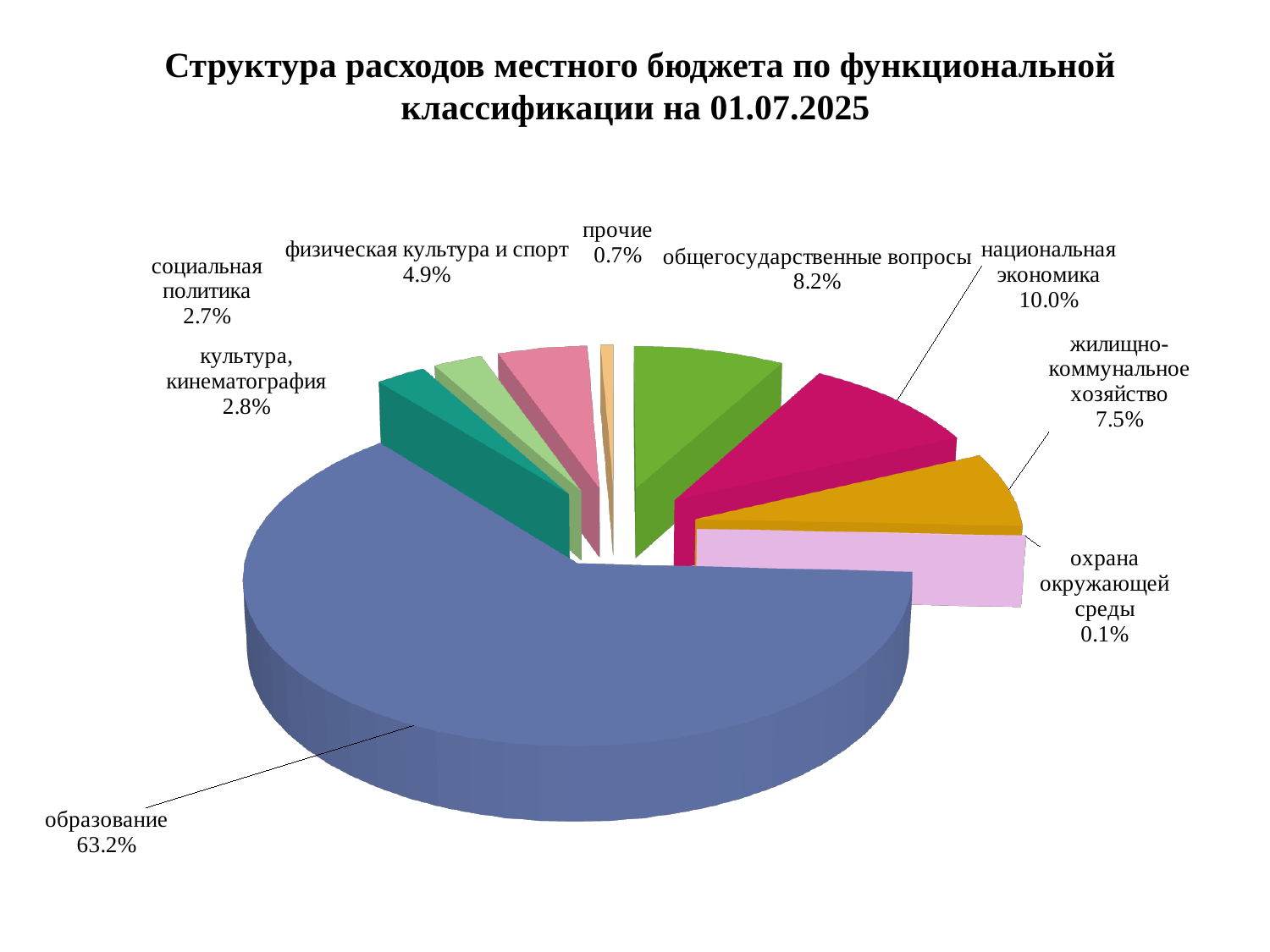
How many categories are shown in the pie chart? 9 What is the difference between the shares of образование and национальная экономика? 53.2% What is the title of the chart? Структура расходов местного бюджета по функциональной классификации на 01.07.2025 What is the value shown for национальная экономика? 10.0% Which category has the largest share of the pie? образование What is the value for охрана окружающей среды? 0.1% What percentage is shown for жилищно-коммунальное хозяйство? 7.5% What kind of chart is shown on the slide? pie chart What share of local budget expenditure goes to образование? 63.2% What is the difference between the shares of общегосударственные вопросы and жилищно-коммунальное хозяйство? 0.7% Which category has the smallest share of the pie? охрана окружающей среды Which is larger: the share for физическая культура и спорт or the share for культура, кинематография? физическая культура и спорт